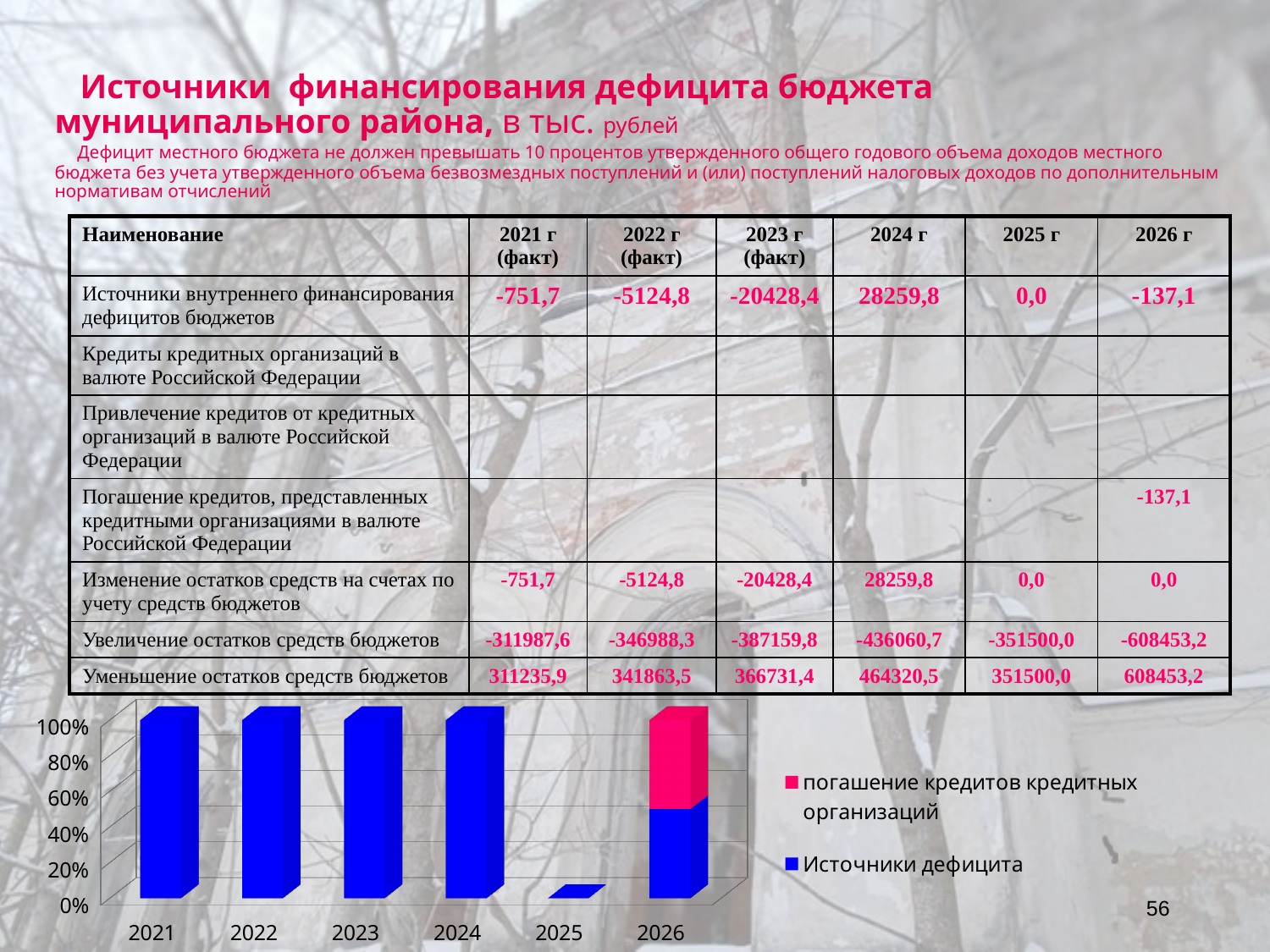
Which series in the bar chart is shown in pink? погашение кредитов кредитных организаций In the bar chart, is the value for Источники дефицита in 2026 greater or less than 80%? less What kind of chart is shown at the bottom of the slide? bar chart In the bar chart, is the value for Источники дефицита in 2021 greater or less than 80%? greater In the bar chart, is the value for Источники дефицита in 2025 greater or less than 20%? less How many years are shown on the x axis of the bar chart? 6 In the bar chart, which is the only year where the pink series погашение кредитов кредитных организаций appears? 2026 How many series does the legend of the bar chart list? 2 Which series in the bar chart is shown in blue? Источники дефицита